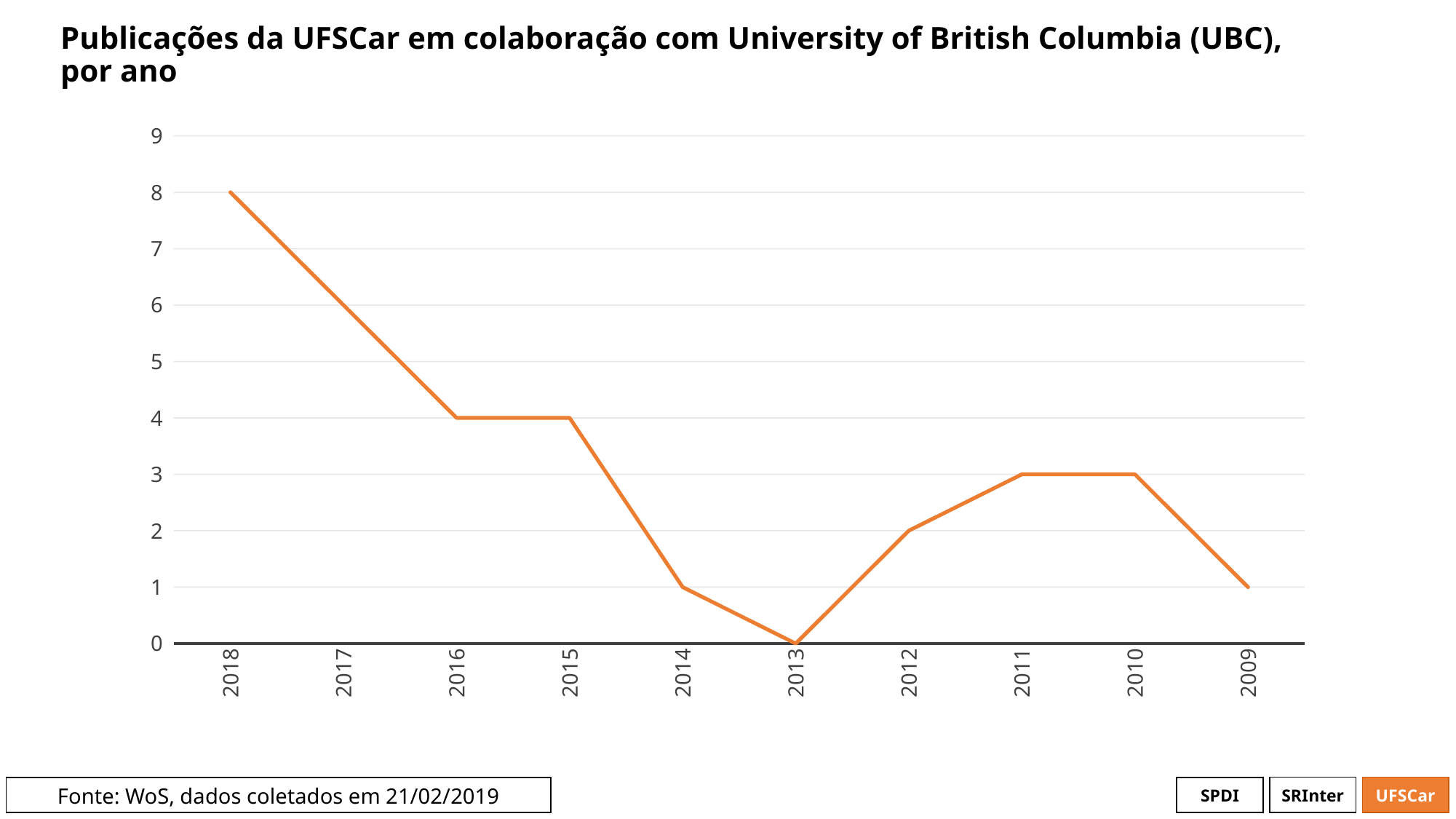
What is the value for 2013? 0 Which year has the highest value? 2018 Which year has the lowest value? 2013 What is the value for 2009? 1 What is the value for 2018? 8 What kind of chart is shown on the slide? line chart What is the value for 2016? 4 Which is larger, the value for 2015 or the value for 2014? 2015 How many years are shown on the x axis? 10 What is the value for 2011? 3 Is the value for 2017 greater or less than 5? greater What is the difference between the values for 2018 and 2016? 4